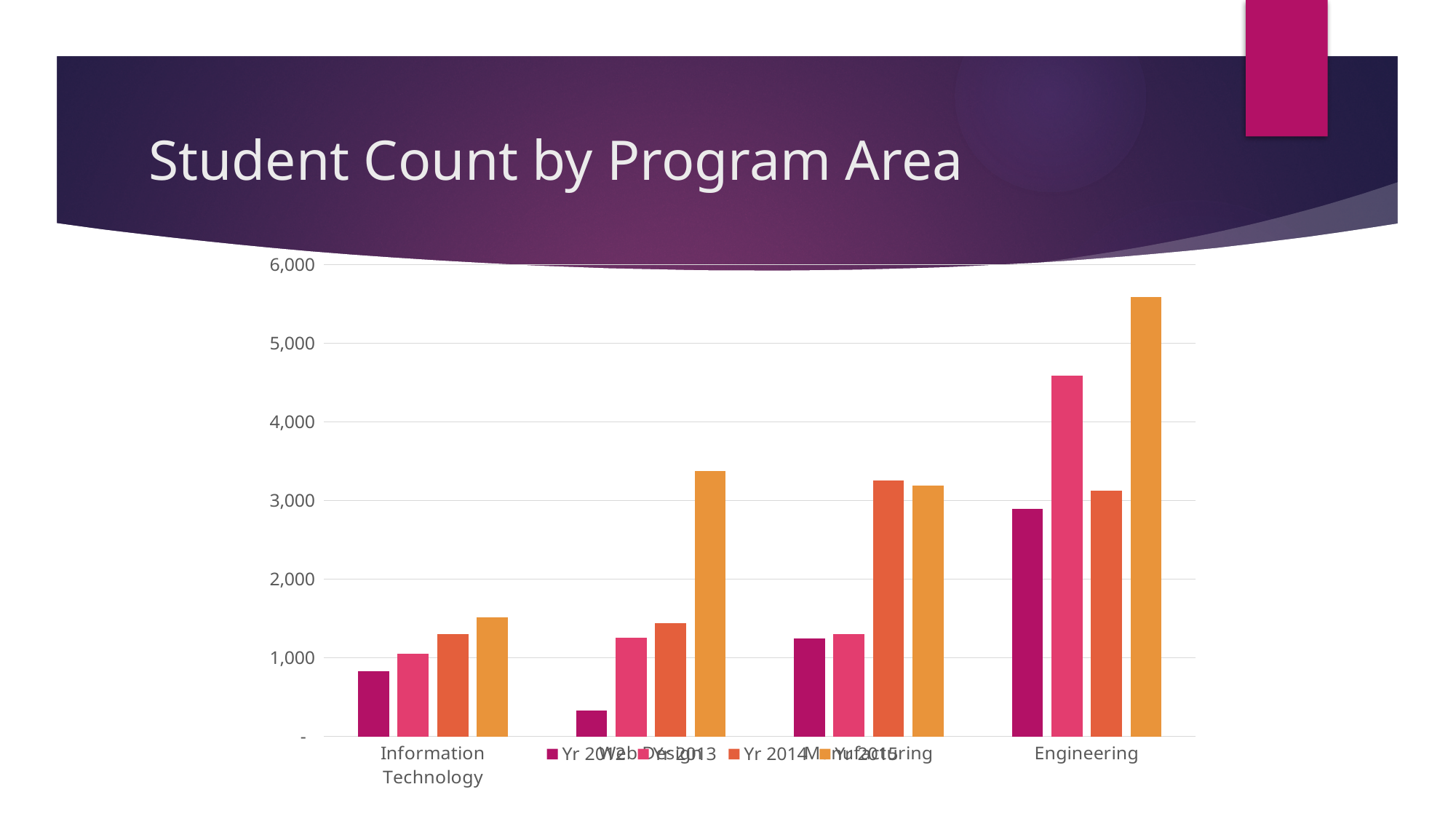
For Engineering, which is larger: the second (pink) bar or the third (orange-red) bar? the second (pink) bar How many program area categories are plotted along the x axis? 4 Within the Information Technology group, do the bars rise or fall from left to right? rise How many series does the legend list? 4 What is the title of the chart on the slide? Student Count by Program Area Is the first (dark magenta) bar for Information Technology greater or less than 1,000? less Which has a taller last (orange) bar: Information Technology or Engineering? Engineering Which program area has the tallest bar in the chart? Engineering Is the tallest bar for Engineering greater or less than 5,000? greater Is the last (orange) bar for Information Technology greater or less than 2,000? less What kind of chart is shown on the slide? bar chart